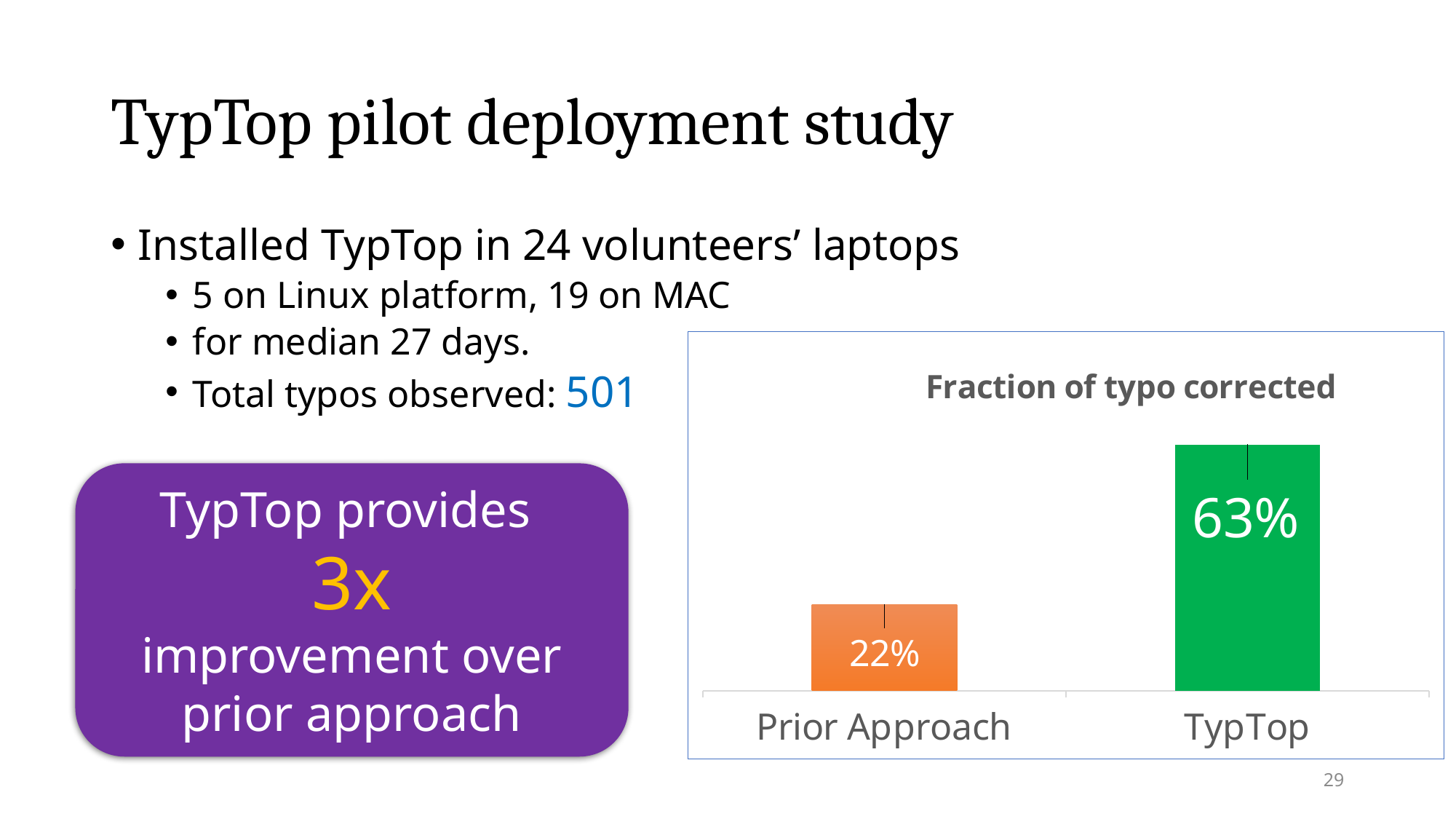
What is the title of the chart? Fraction of typo corrected What kind of chart is shown on the slide? Bar chart What is the difference between the fraction of typo corrected for TypTop and for Prior Approach? 41% Do the values rise or fall from Prior Approach to TypTop? Rise What is the fraction of typo corrected for Prior Approach? 22% What colour is the bar for TypTop? Green What is the fraction of typo corrected for TypTop? 63% Which category has the lowest fraction of typo corrected? Prior Approach Which category has the highest fraction of typo corrected? TypTop How many categories are shown in the chart? 2 Which has a larger fraction of typo corrected, Prior Approach or TypTop? TypTop